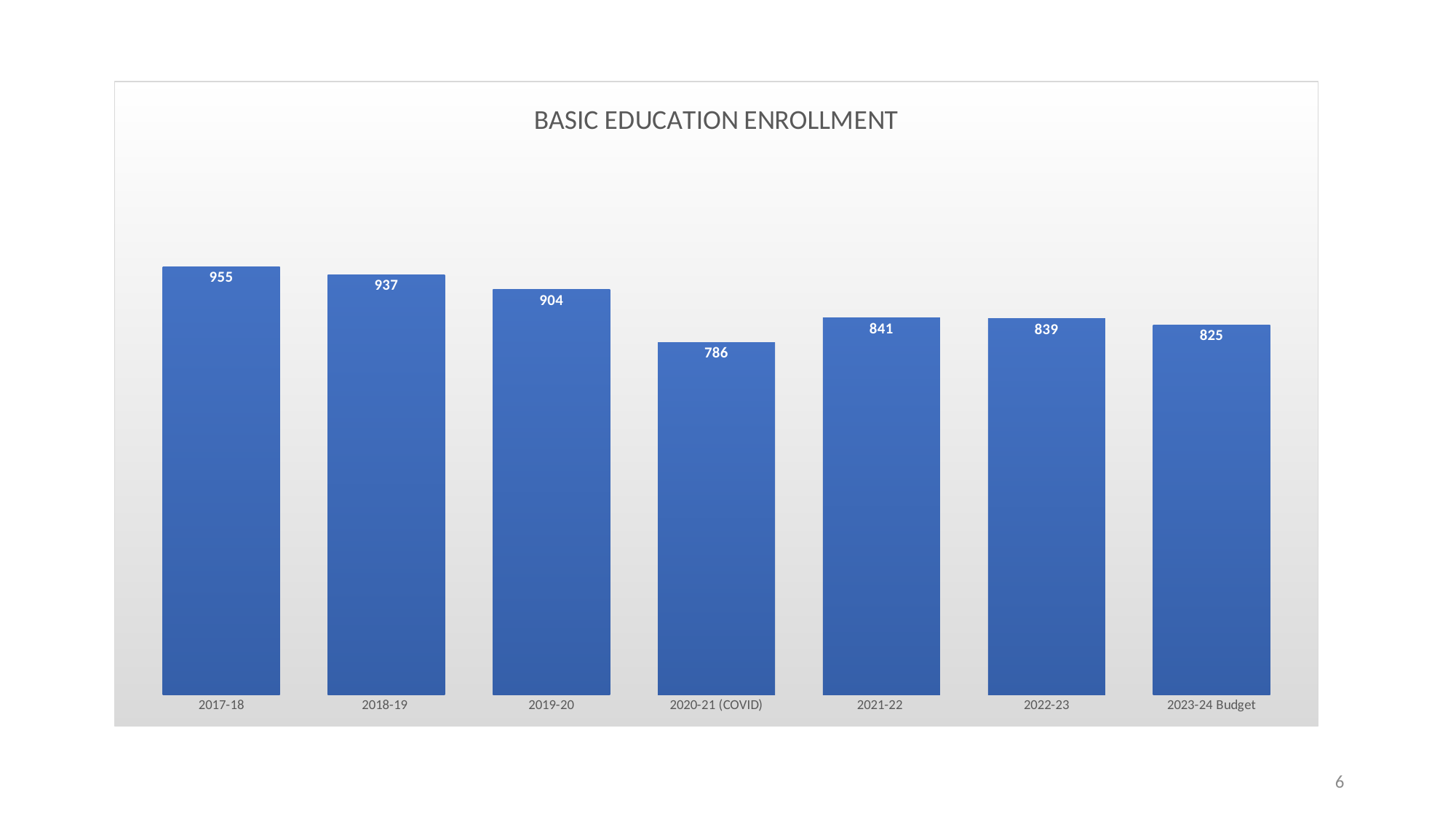
Which year has the lowest enrollment? 2020-21 (COVID) What is the enrollment value for 2017-18? 955 What is the difference in enrollment between 2017-18 and 2020-21 (COVID)? 169 Which year has the highest enrollment? 2017-18 Does enrollment rise or fall from 2017-18 to 2020-21 (COVID)? Fall How many years are shown on the chart? 7 What is the difference in enrollment between 2021-22 and 2023-24 Budget? 16 What is the title of the chart? BASIC EDUCATION ENROLLMENT Which has a larger enrollment, 2019-20 or 2022-23? 2019-20 What is the enrollment value for 2020-21 (COVID)? 786 What kind of chart is this? Bar chart What is the enrollment value for 2023-24 Budget? 825